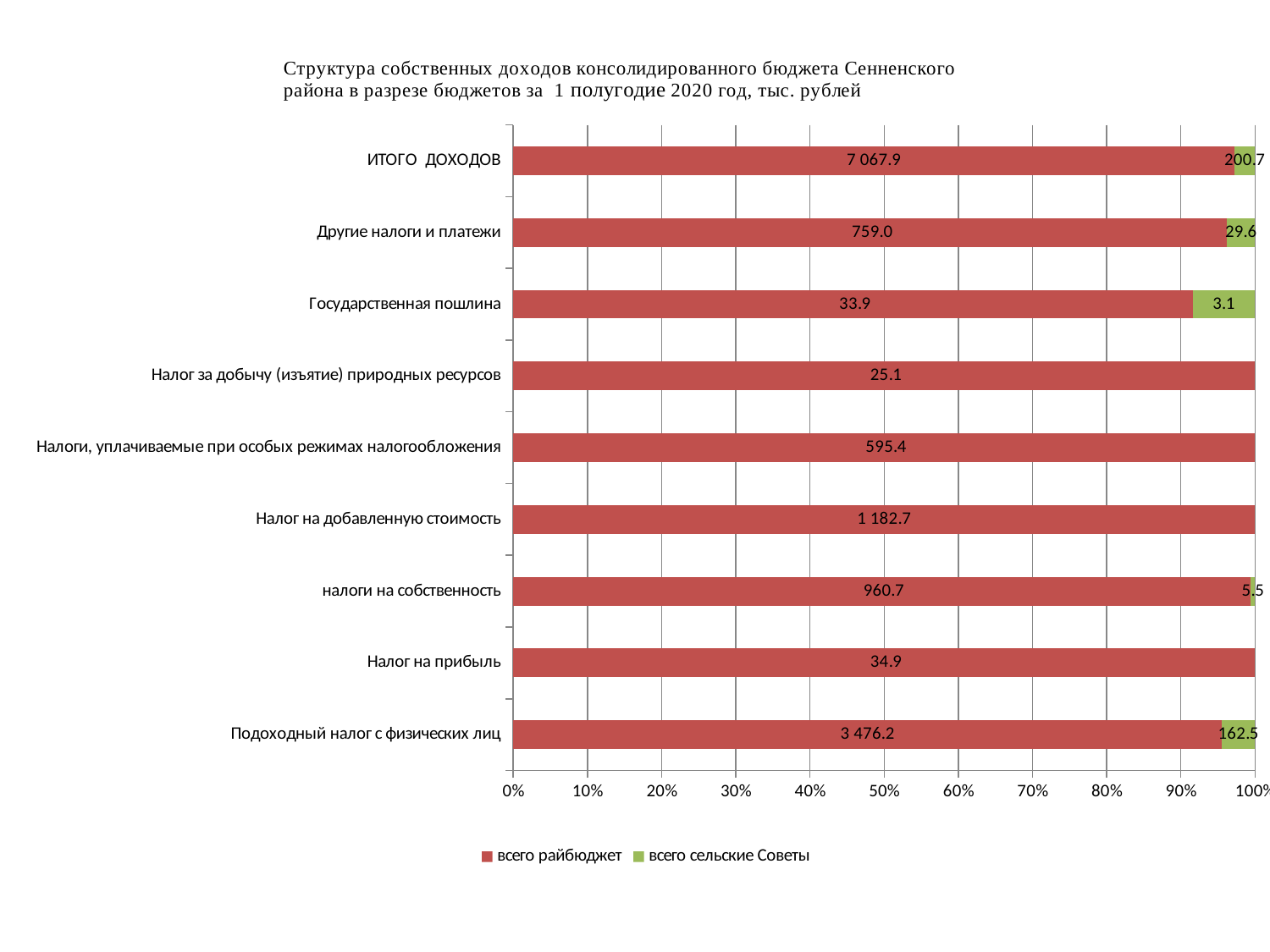
Which category has the lowest value for всего райбюджет? Налог за добычу (изъятие) природных ресурсов What is the value for всего райбюджет for Налог на добавленную стоимость? 1 182.7 What is the total of the ИТОГО ДОХОДОВ bar (всего райбюджет plus всего сельские Советы)? 7 268.6 What is the value for всего сельские Советы for Государственная пошлина? 3.1 How many series does the legend list? 2 Which is larger for всего райбюджет: налоги на собственность or Налоги, уплачиваемые при особых режимах налогообложения? налоги на собственность What kind of chart is shown on the slide? Stacked bar chart Excluding ИТОГО ДОХОДОВ, which category has the highest value for всего райбюджет? Подоходный налог с физических лиц What is the difference between the всего райбюджет and всего сельские Советы values for Другие налоги и платежи? 729.4 What is the value for всего сельские Советы in the Подоходный налог с физических лиц bar? 162.5 How many categories are shown on the vertical axis? 9 What is the value for всего райбюджет in the ИТОГО ДОХОДОВ bar? 7 067.9